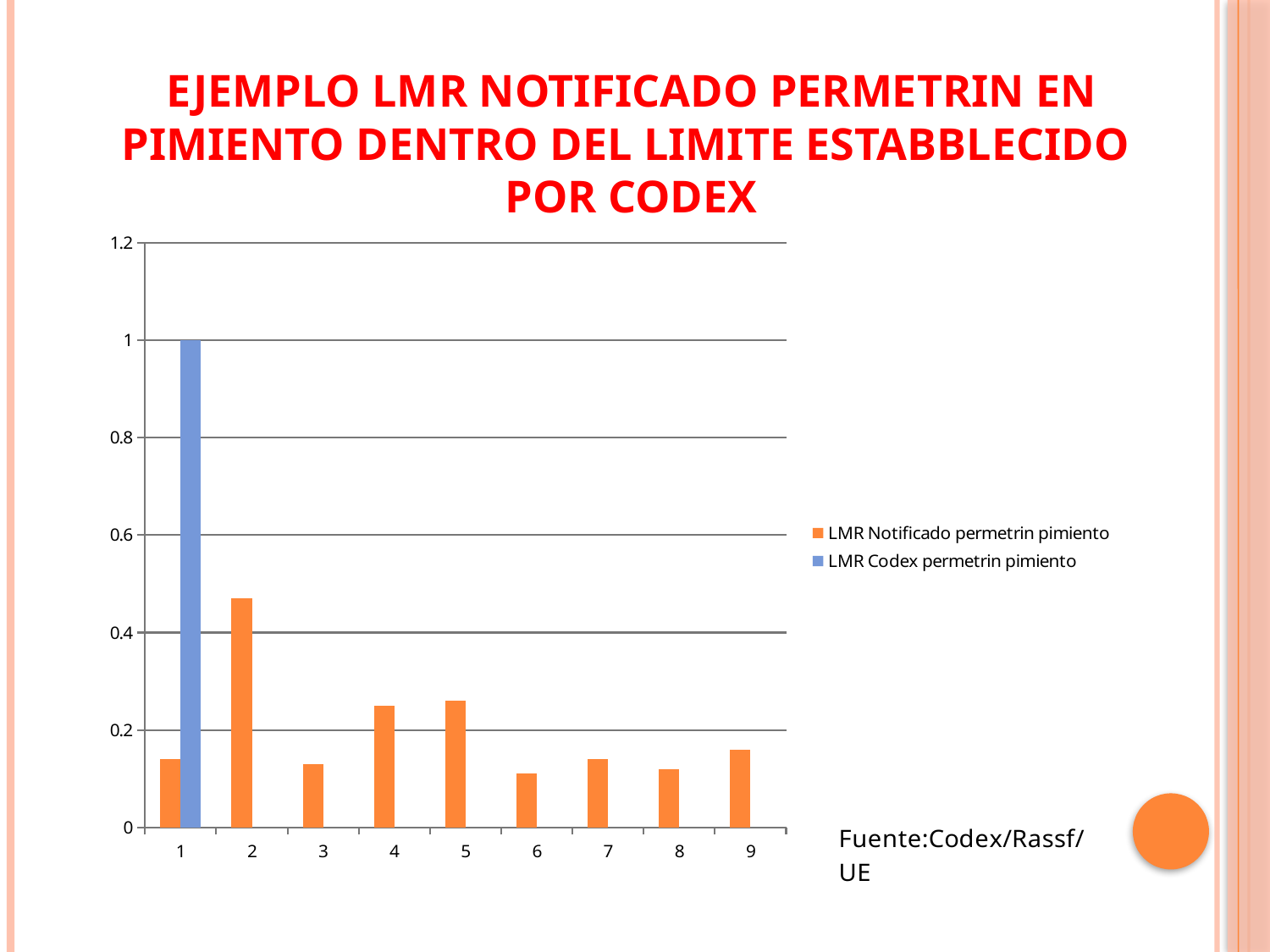
Is the LMR Notificado permetrin pimiento value for category 4 greater or less than 0.2? greater Which is larger, the LMR Notificado permetrin pimiento value for category 2 or for category 3? category 2 How many series does the chart legend list? 2 What kind of chart is shown on the slide? bar chart What is the value of the LMR Codex permetrin pimiento bar at category 1? 1 Which category has the highest LMR Notificado permetrin pimiento value? 2 Which is larger at category 1, the LMR Notificado permetrin pimiento bar or the LMR Codex permetrin pimiento bar? LMR Codex permetrin pimiento Which series is shown in blue in the chart? LMR Codex permetrin pimiento Is the LMR Notificado permetrin pimiento value for category 2 greater or less than 0.4? greater Is the LMR Notificado permetrin pimiento value for category 6 greater or less than 0.2? less What source is cited below the chart? Fuente:Codex/Rassf/UE How many categories are shown along the x axis of the chart? 9